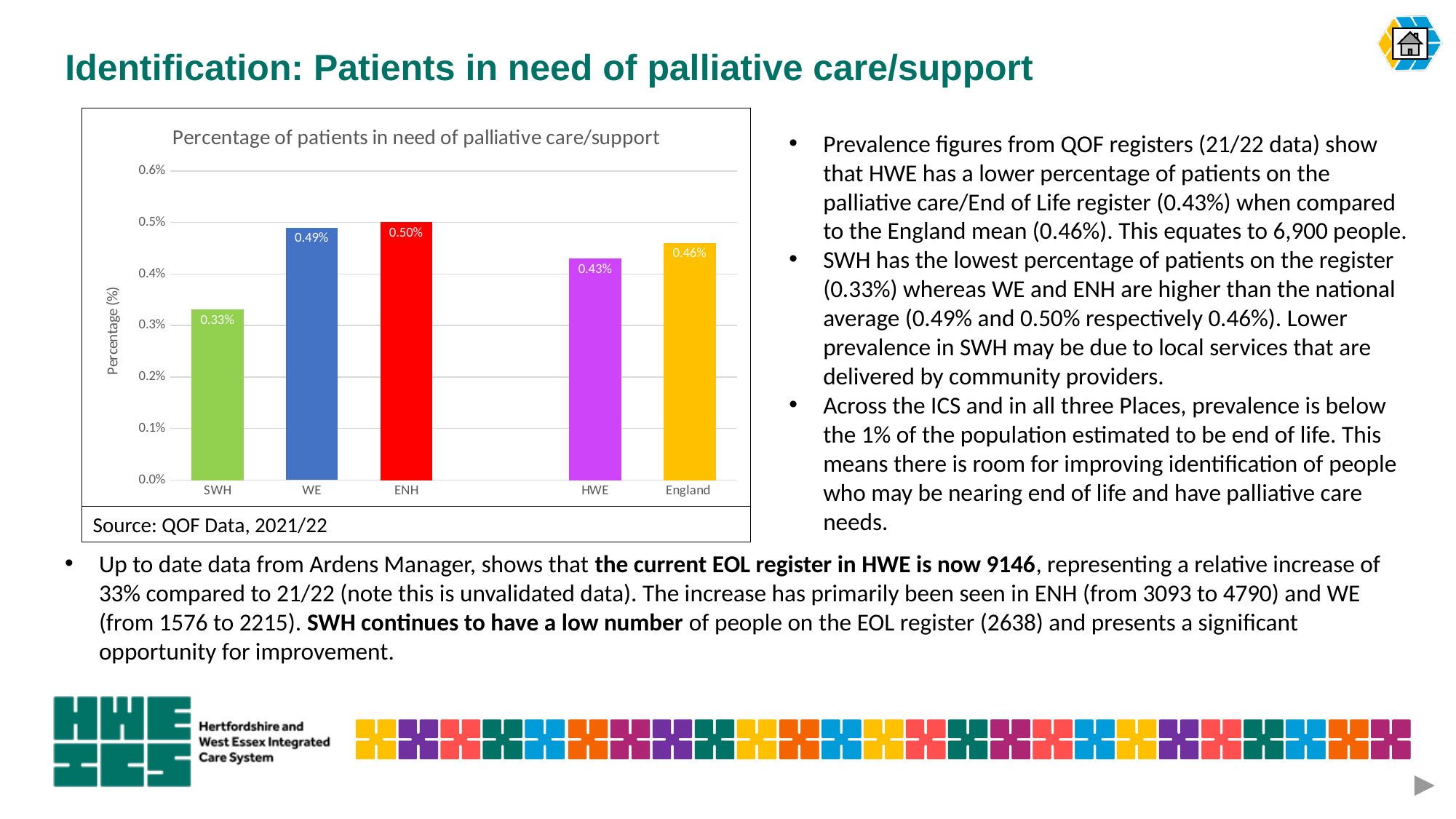
How many categories are shown on the x axis of the chart? 5 What kind of chart is shown on the slide? bar chart Which category has the lowest percentage of patients in need of palliative care/support? SWH What is the difference between the percentage for England and the percentage for HWE? 0.03% Which has a higher percentage of patients in need of palliative care/support, WE or HWE? WE What is the difference between the percentage for ENH and the percentage for SWH? 0.17% Which category has the highest percentage of patients in need of palliative care/support? ENH What is the title of the chart? Percentage of patients in need of palliative care/support What is the percentage of patients in need of palliative care/support for ENH? 0.50% What is the percentage of patients in need of palliative care/support for SWH? 0.33% Is the value for SWH greater or less than 0.4%? less What is the percentage of patients in need of palliative care/support for England? 0.46%